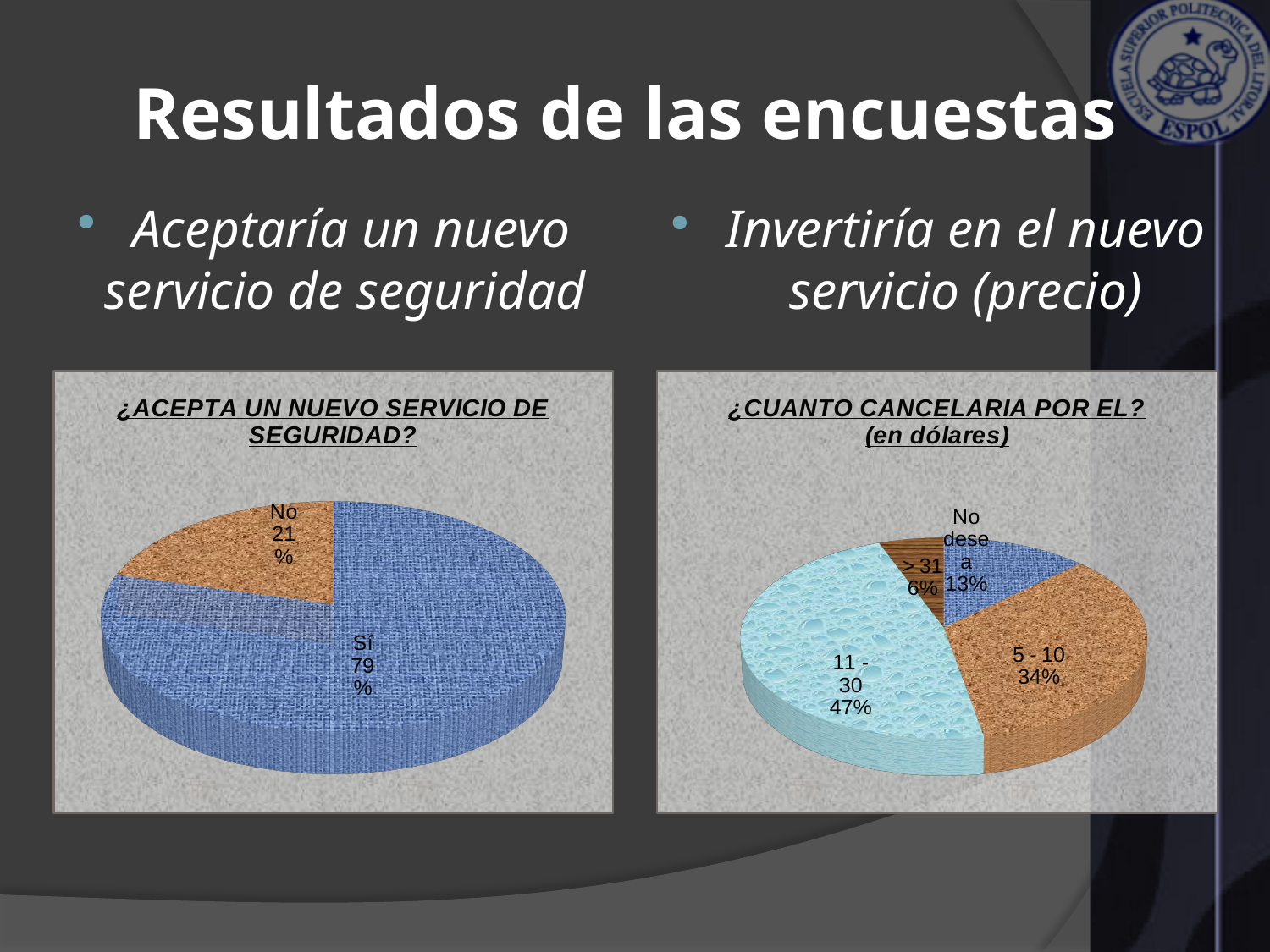
In the chart titled '¿CUANTO CANCELARIA POR EL?', which slice is the smallest? > 31 In the chart titled '¿ACEPTA UN NUEVO SERVICIO DE SEGURIDAD?', which slice is the largest? Sí In the chart titled '¿CUANTO CANCELARIA POR EL?', what share of the pie is '> 31'? 6% In the chart titled '¿CUANTO CANCELARIA POR EL?', what share of the pie is 'No desea'? 13% In the chart titled '¿CUANTO CANCELARIA POR EL?', how many slices does the pie have? 4 In the chart titled '¿ACEPTA UN NUEVO SERVICIO DE SEGURIDAD?', what share of the pie is 'No'? 21% What kind of chart is the one on the left of the slide? Pie chart In the chart titled '¿CUANTO CANCELARIA POR EL?', which is larger, '5 - 10' or 'No desea'? 5 - 10 In the chart titled '¿ACEPTA UN NUEVO SERVICIO DE SEGURIDAD?', what is the difference between the 'Sí' and 'No' shares? 58%